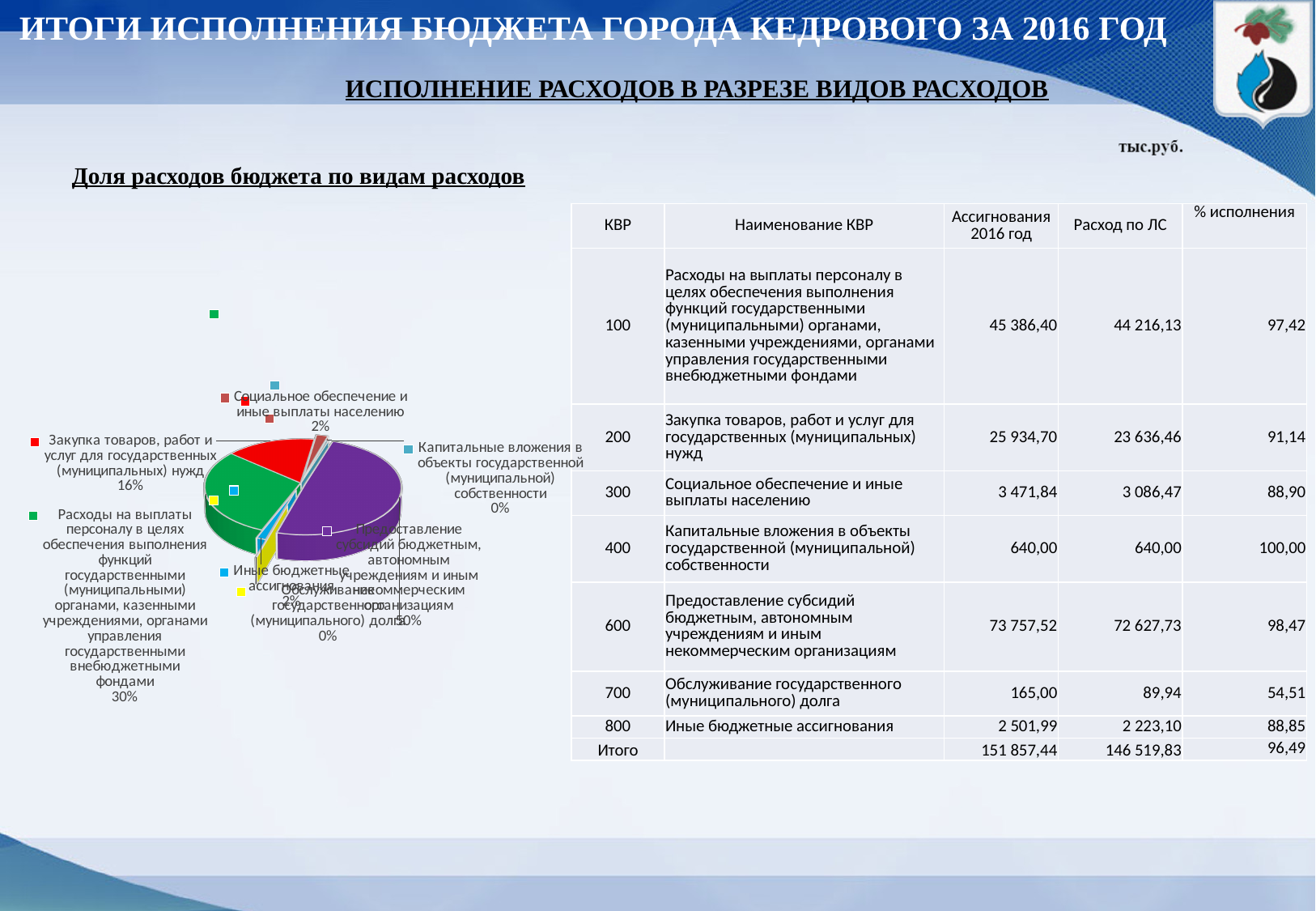
Which is larger: the share for "Закупка товаров, работ и услуг для государственных (муниципальных) нужд" or the share for "Расходы на выплаты персоналу"? Расходы на выплаты персоналу How many categories are shown in the pie chart? 7 Which category has the largest share of the pie? Предоставление субсидий бюджетным, автономным учреждениям и иным некоммерческим организациям What share of the pie does "Капитальные вложения в объекты государственной (муниципальной) собственности" have? 0% What is the difference in percentage points between the share for "Предоставление субсидий" and the share for "Расходы на выплаты персоналу"? 20 What share of the pie does "Закупка товаров, работ и услуг для государственных (муниципальных) нужд" have? 16% What share of the pie does "Расходы на выплаты персоналу в целях обеспечения выполнения функций государственными (муниципальными) органами, казенными учреждениями, органами управления государственными внебюджетными фондами" have? 30% What is the title of the pie chart? Доля расходов бюджета по видам расходов What kind of chart is shown on the slide? pie chart